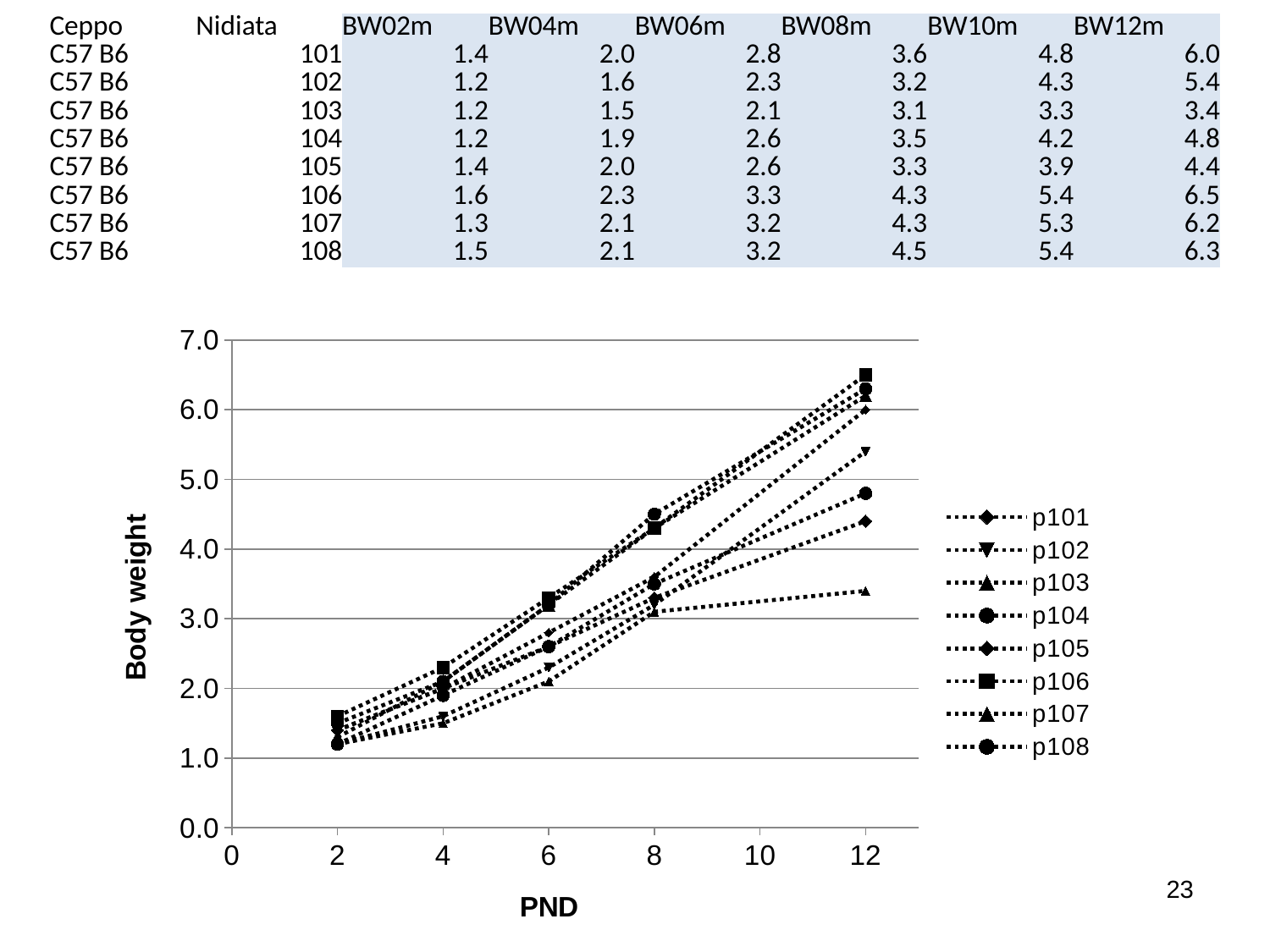
What is the difference in body weight between p106 and p103 at PND 12? 3.1 What kind of chart is shown on the slide? line chart Which series has the larger body weight at PND 12, p102 or p104? p102 Which series has the lowest body weight at PND 12? p103 What is the body weight of p103 at PND 12? 3.4 Do the body weight values rise or fall as PND increases? rise Is the body weight of p103 at PND 12 greater or less than 4.0? less What is the label of the x axis of the chart? PND Which series has the highest body weight at PND 12? p106 What is the label of the y axis of the chart? Body weight How many series does the chart legend list? 8 What is the body weight of p106 at PND 12? 6.5